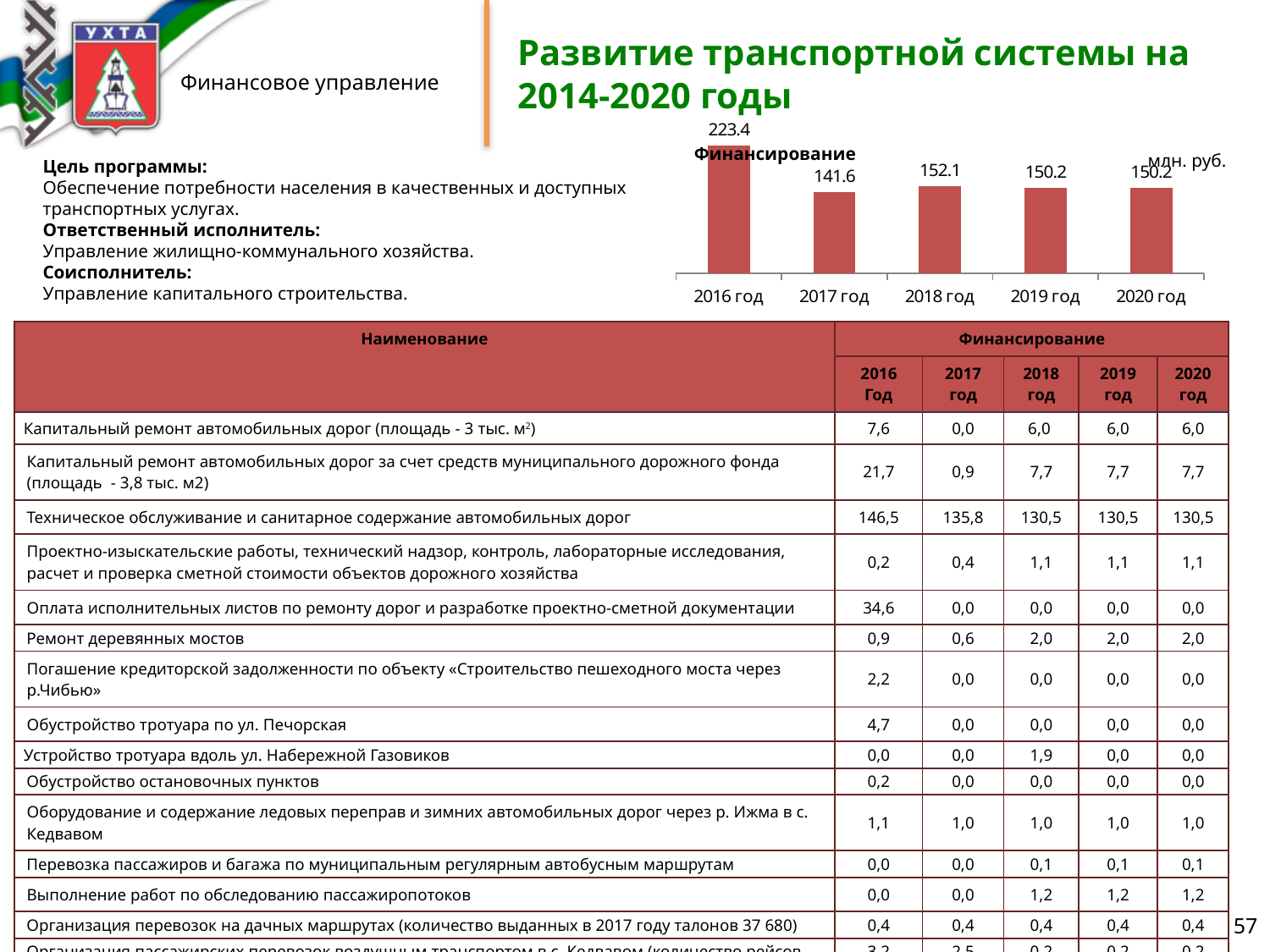
Which year has the highest value in the Финансирование chart? 2016 год What is the value for 2017 год in the Финансирование chart? 141.6 Which year has the lowest value in the Финансирование chart? 2017 год What unit is indicated for the values in the Финансирование chart? млн. руб. What is the difference between the values for 2018 год and 2019 год in the Финансирование chart? 1.9 What is the value for 2019 год in the Финансирование chart? 150.2 What is the difference between the values for 2016 год and 2017 год in the Финансирование chart? 81.8 Which is larger in the Финансирование chart, the value for 2017 год or the value for 2018 год? 2018 год What is the value for 2018 год in the Финансирование chart? 152.1 How many years are shown in the Финансирование chart? 5 What kind of chart is the Финансирование chart? bar chart What is the value for 2016 год in the Финансирование chart? 223.4